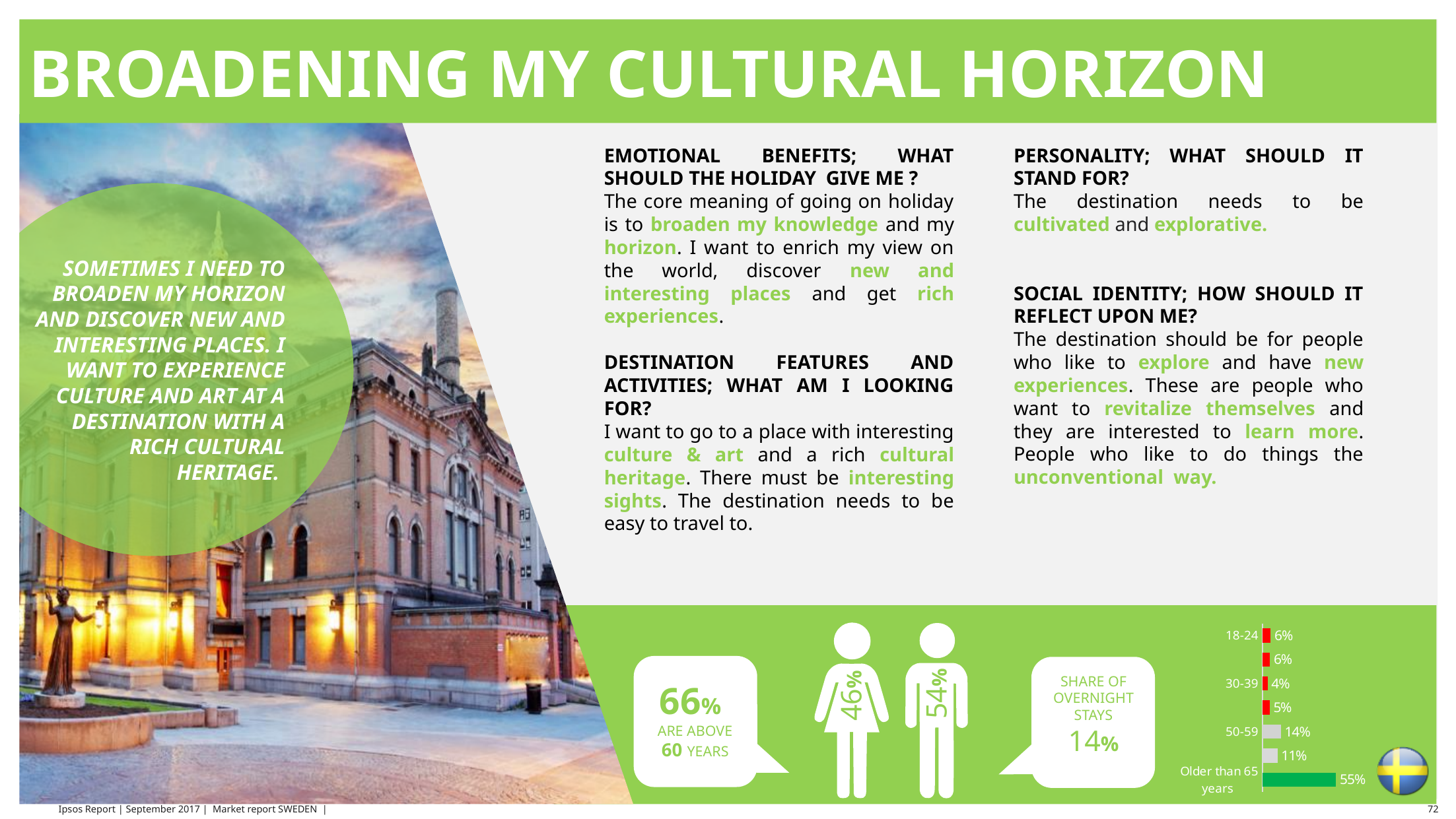
In the age-group bar chart, which labelled age group has the lowest value? 30-39 How many bars are plotted in the age-group bar chart? 7 In the age-group bar chart, what is the value for 18-24? 6% In the age-group bar chart, which labelled age group has the highest value? Older than 65 years In the age-group bar chart, what is the value for 50-59? 14% In the age-group bar chart, what colour is the bar for Older than 65 years? green In the age-group bar chart, what is the value for Older than 65 years? 55% What kind of chart is shown at the bottom right of the slide? bar chart In the age-group bar chart, what is the difference between the values for Older than 65 years and 50-59? 41% In the age-group bar chart, what is the difference between the values for 18-24 and 30-39? 2% In the age-group bar chart, which is larger, the value for 50-59 or the value for 18-24? 50-59 In the age-group bar chart, what is the value for 30-39? 4%